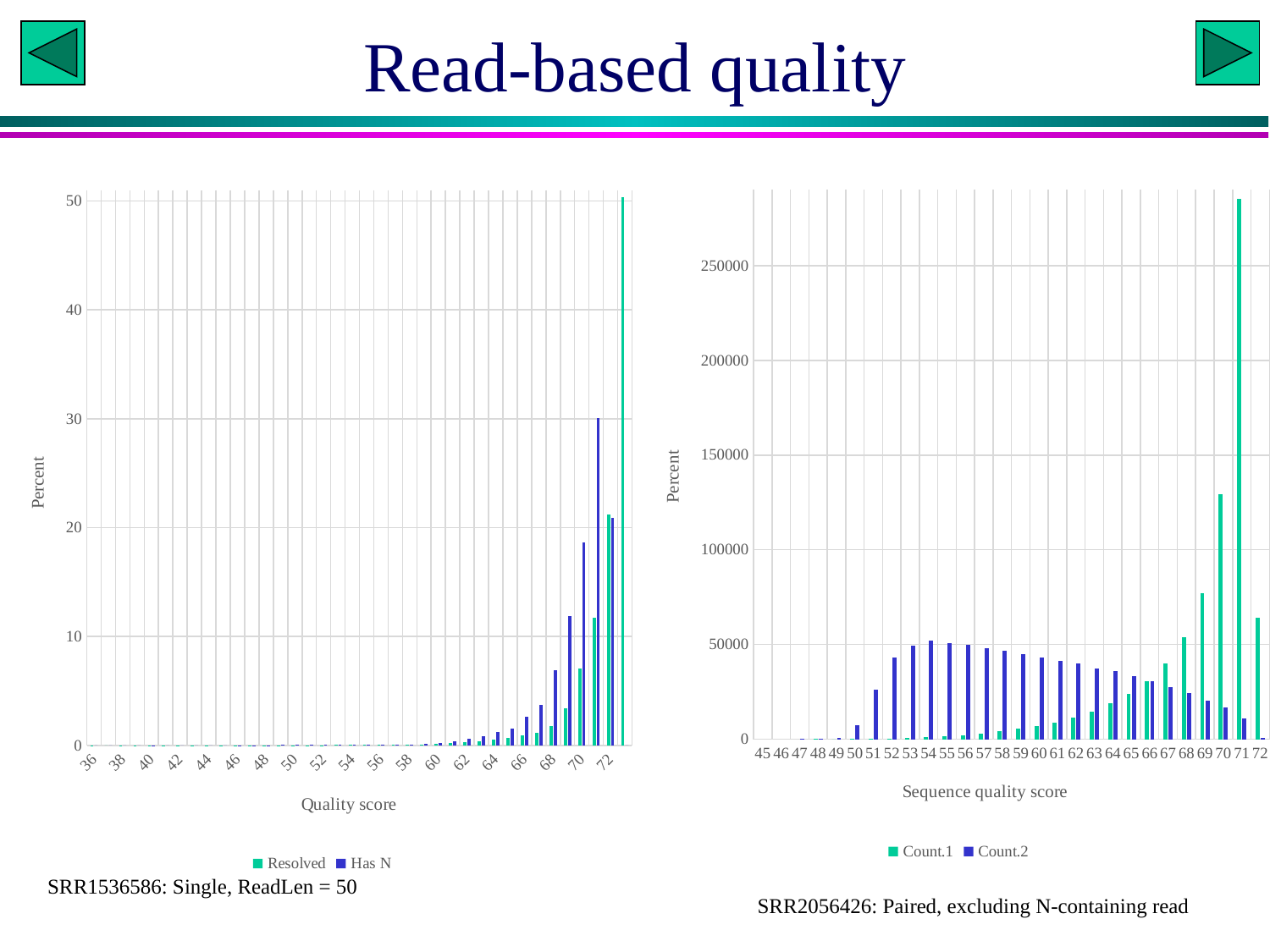
What kind of chart is the left chart (Quality score vs Percent)? bar chart In the left chart, is the Has N value at quality score 71 greater or less than 20? greater In the right chart, is the Count.1 value at sequence quality score 70 greater or less than 100000? greater In the right chart, at sequence quality score 54, which series has the larger value, Count.1 or Count.2? Count.2 In the left chart, is the Has N value at quality score 70 greater or less than 10? greater In the right chart, which sequence quality score has the highest Count.1 value? 71 What are the legend entries of the left chart? Resolved, Has N How many sequence quality score categories are shown on the x axis of the right chart? 28 How many series does the legend of the left chart list? 2 In the left chart, at quality score 70, which series has the larger value, Resolved or Has N? Has N What is the x-axis title of the right chart? Sequence quality score